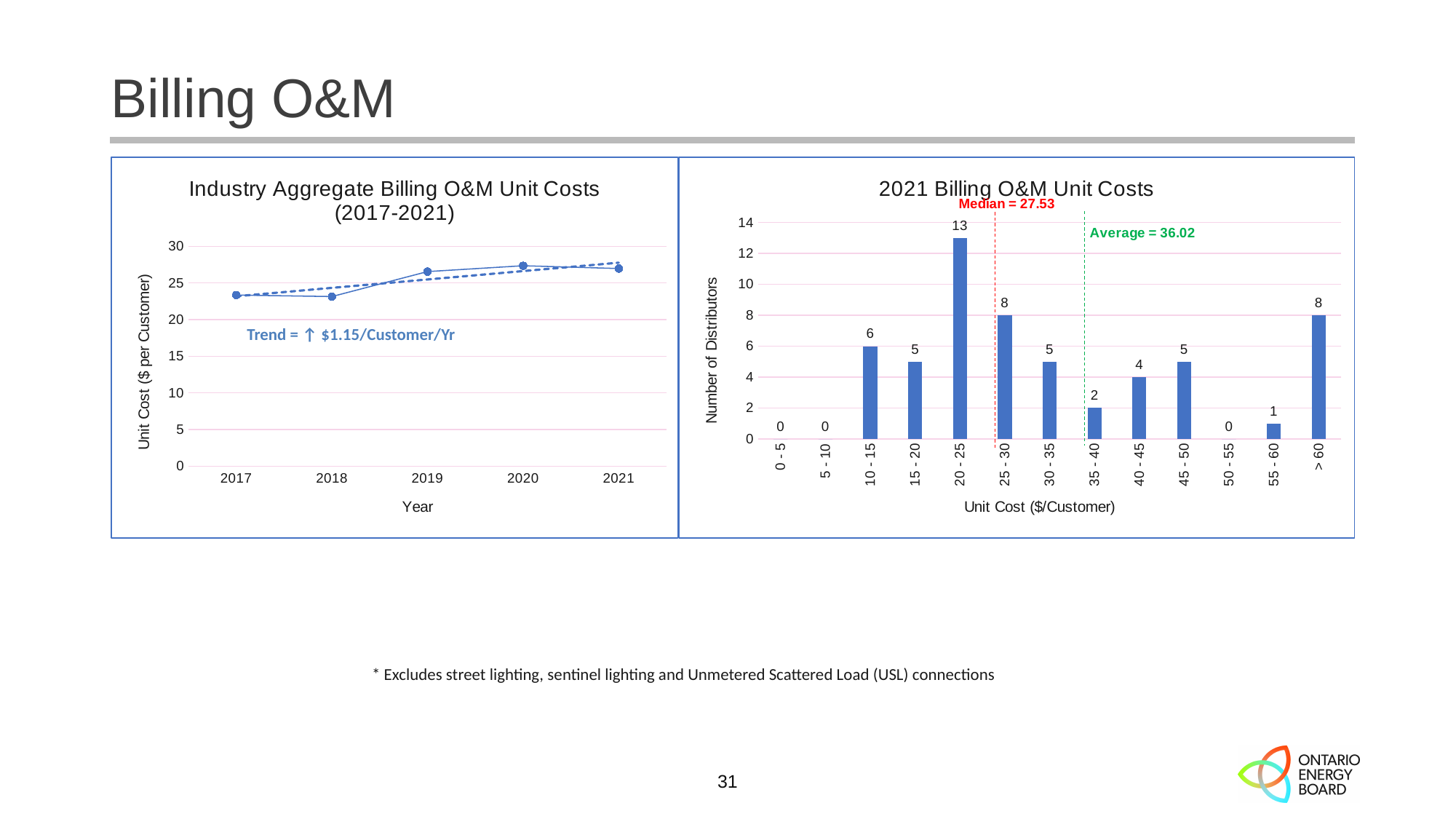
On the right chart, 2021 Billing O&M Unit Costs, what is the median value annotated on the chart? 27.53 On the right chart, 2021 Billing O&M Unit Costs, which range has more distributors, 10 - 15 or 15 - 20? 10 - 15 On the right chart, 2021 Billing O&M Unit Costs, how many distributors are in the 20 - 25 unit cost range? 13 On the left chart, Industry Aggregate Billing O&M Unit Costs (2017-2021), what kind of chart is used? line chart On the right chart, 2021 Billing O&M Unit Costs, which unit cost range has the highest number of distributors? 20 - 25 On the left chart, Industry Aggregate Billing O&M Unit Costs (2017-2021), what trend value is annotated on the chart? ↑ $1.15/Customer/Yr On the left chart, Industry Aggregate Billing O&M Unit Costs (2017-2021), do the unit costs generally rise or fall from 2017 to 2021? rise On the right chart, 2021 Billing O&M Unit Costs, how many unit cost ranges are shown on the x axis? 13 On the left chart, Industry Aggregate Billing O&M Unit Costs (2017-2021), how many years are plotted? 5 On the left chart, Industry Aggregate Billing O&M Unit Costs (2017-2021), is the value for 2020 greater or less than 25? greater On the left chart, Industry Aggregate Billing O&M Unit Costs (2017-2021), is the value for 2017 greater or less than 25? less On the right chart, 2021 Billing O&M Unit Costs, what is the difference between the number of distributors in the 20 - 25 range and the 25 - 30 range? 5